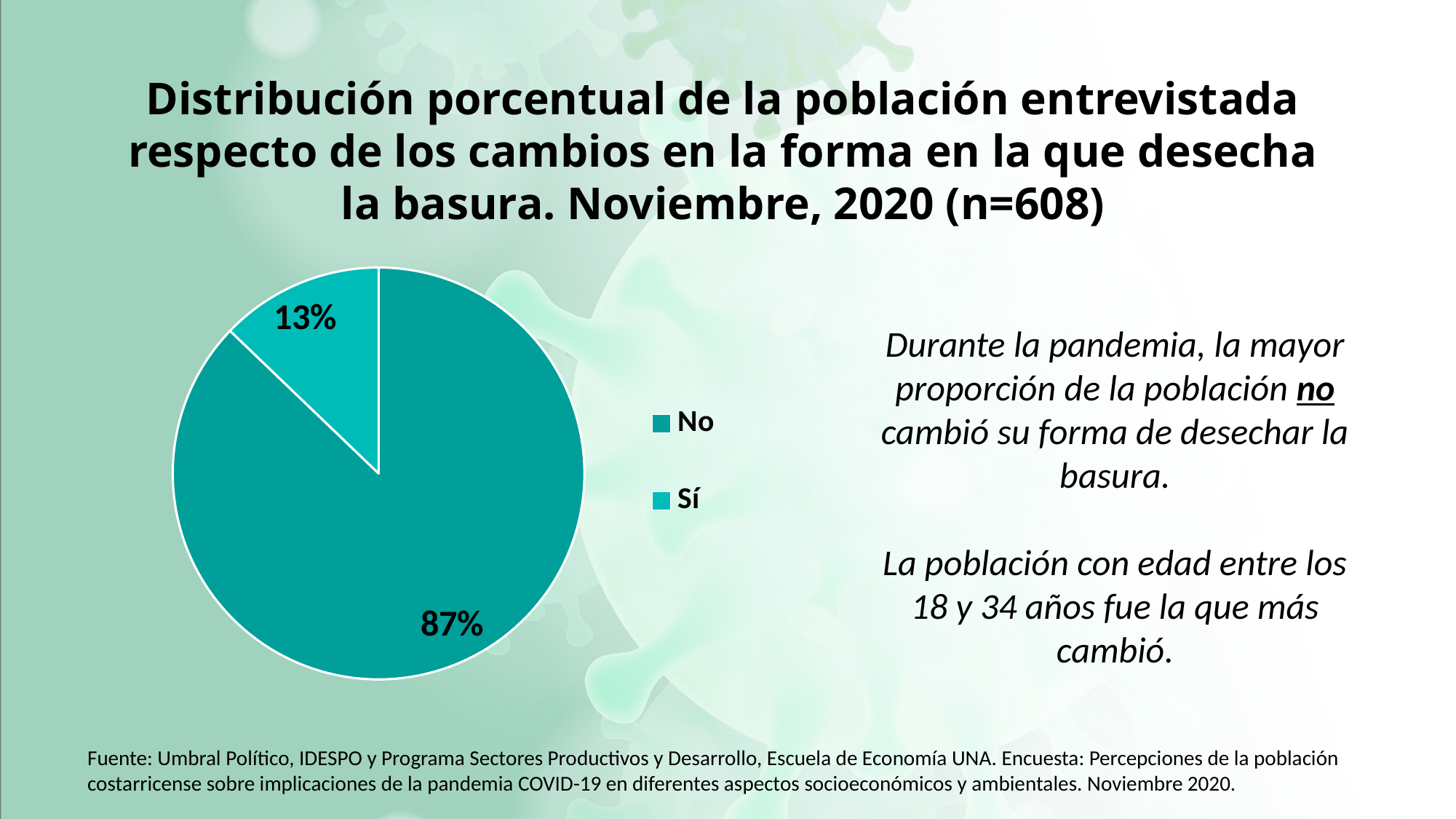
Which category has the largest share of the pie? No What share of the pie does the "Sí" slice represent? 13% How many entries does the legend list? 2 What is the sample size (n) stated in the chart title? 608 Which legend entry is shown in the lighter teal colour? Sí What is the difference in percentage points between the "No" and "Sí" slices? 74 Which category has the smallest share of the pie? Sí What percentage of respondents answered "Sí"? 13% How many slices does the pie chart have? 2 Which is larger, the "No" slice or the "Sí" slice? No What percentage of respondents answered "No"? 87% What kind of chart is shown on the slide? pie chart